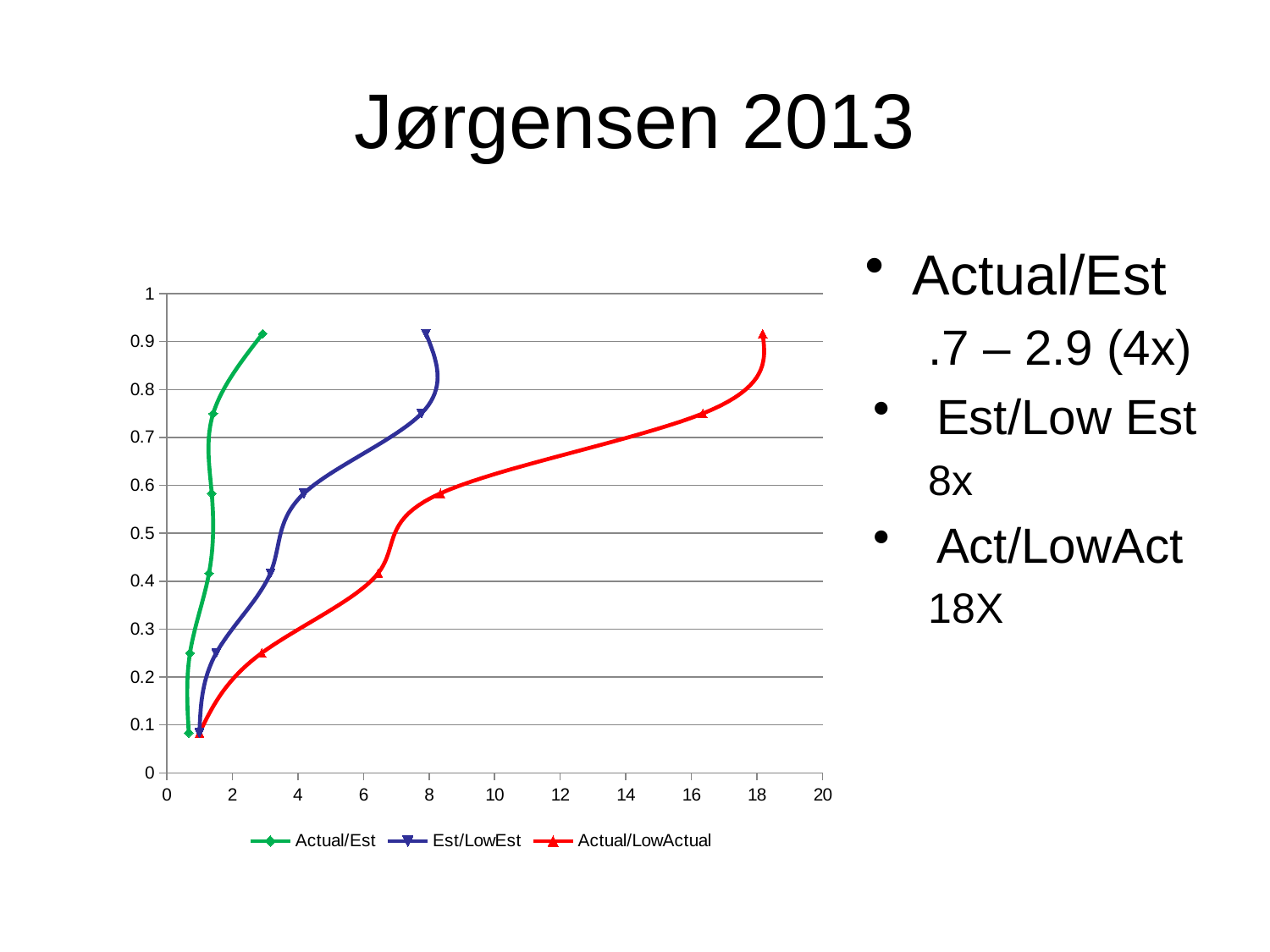
What kind of chart is shown on the slide? line chart Is the horizontal-axis value of the topmost Est/LowEst point greater or less than 10? less Which series reaches the highest value on the horizontal axis? Actual/LowActual Is the horizontal-axis value of the topmost Actual/Est point greater or less than 4? less Do the horizontal-axis values of the Actual/LowActual series rise or fall as the vertical-axis value increases? rise What colour is the Est/LowEst series drawn in? blue How many marked data points does the Actual/LowActual series have? 6 How many series does the chart legend list? 3 Which series stays lowest on the horizontal axis across the whole chart? Actual/Est Is the horizontal-axis value of the Actual/LowActual point at about 0.75 on the vertical axis greater or less than 14? greater At the topmost point, which series has the larger horizontal-axis value, Est/LowEst or Actual/Est? Est/LowEst